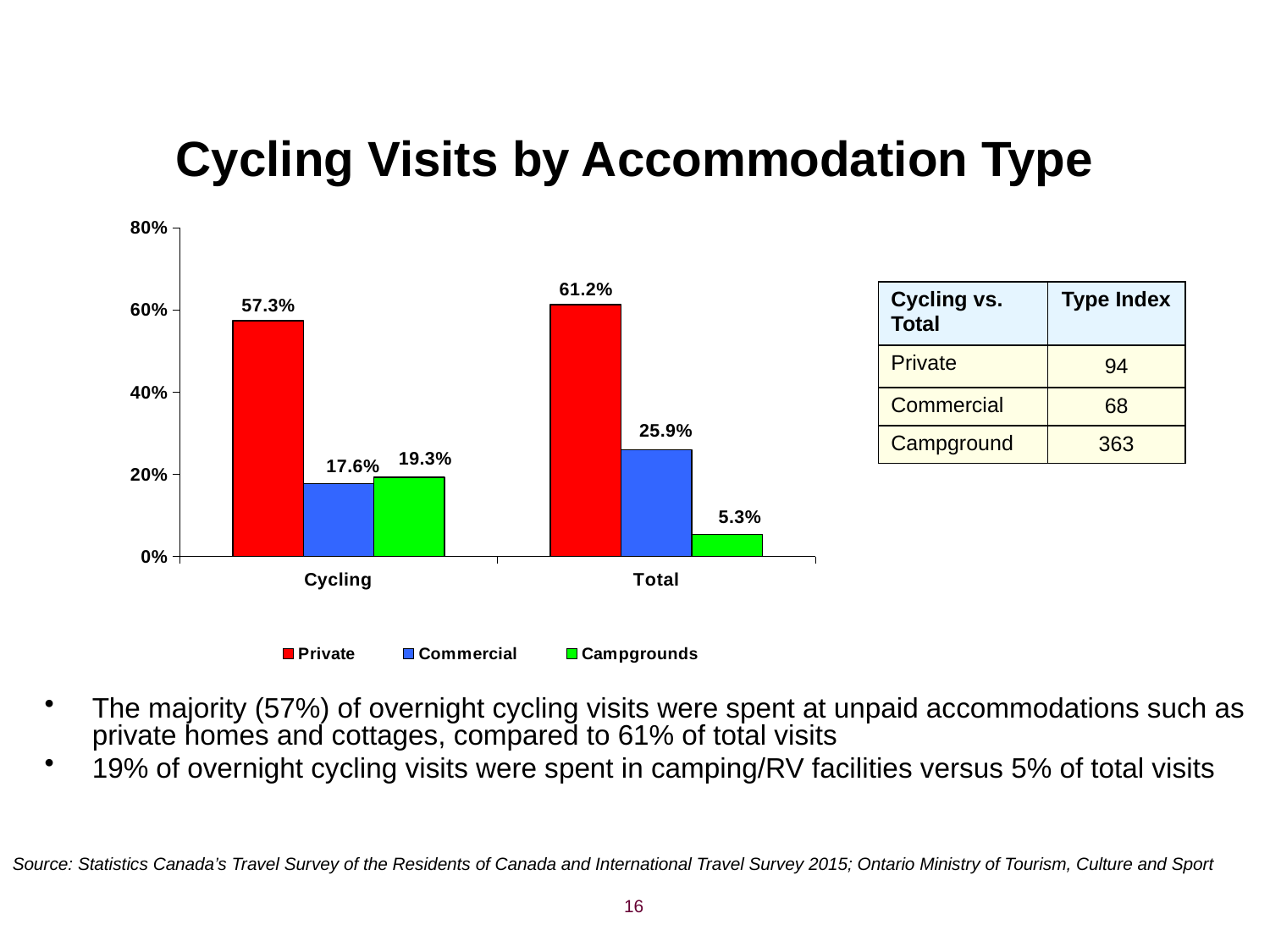
What is the value for Private in the Cycling group? 57.3% What colour represents the Campgrounds series? green Which is larger: Campgrounds for Cycling or Campgrounds for Total? Campgrounds for Cycling What is the value for Campgrounds in the Total group? 5.3% Which series has the lowest value in the Cycling group? Commercial How many series does the legend list? 3 What kind of chart is shown on the slide? bar chart How many categories are shown on the x axis? 2 What is the value for Commercial in the Total group? 25.9% Which series has the highest value in the Total group? Private What is the difference between the Private values for Total and Cycling? 3.9% Is the value for Commercial in the Cycling group greater or less than 20%? less